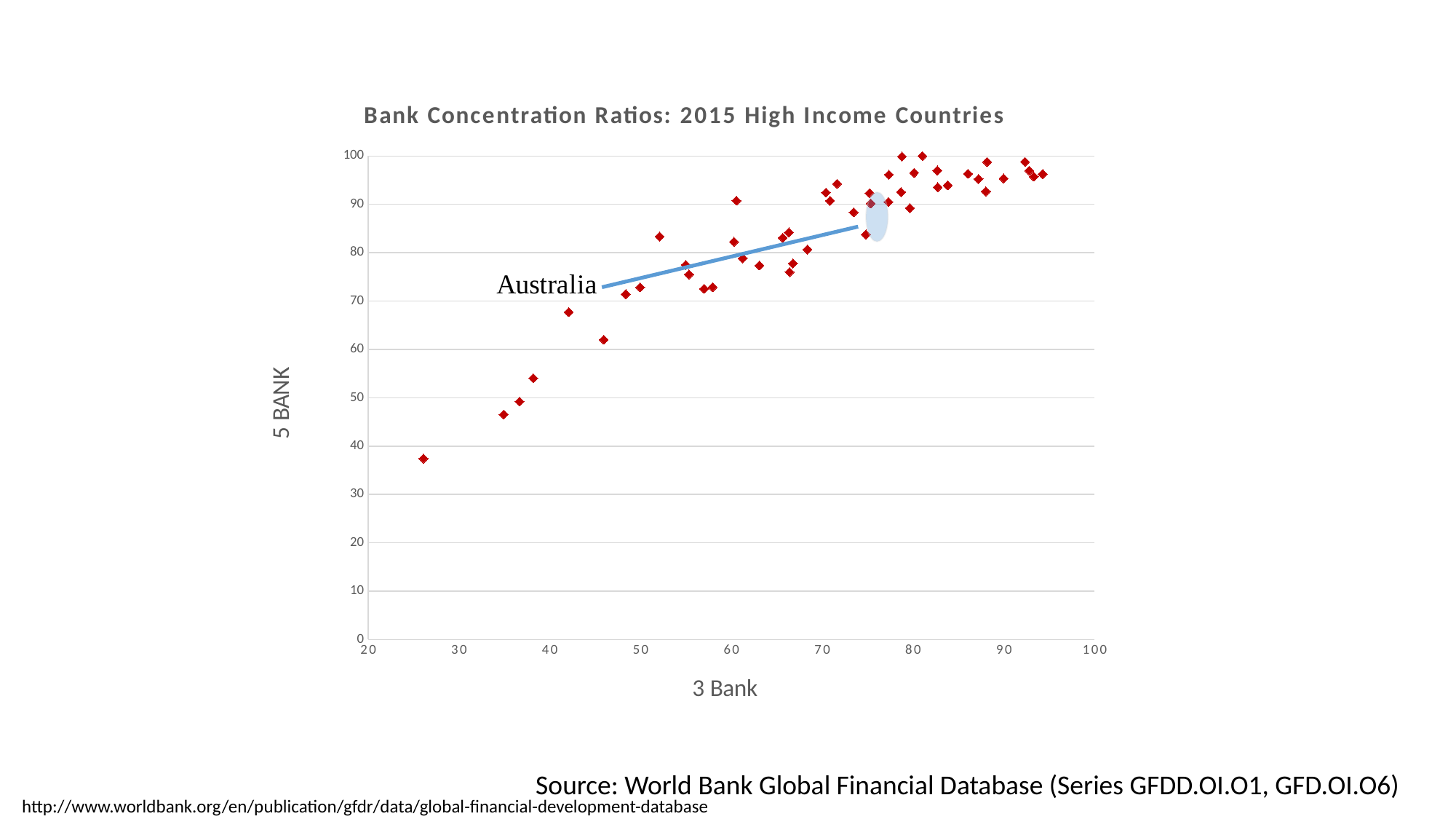
Is the 3 Bank value for the point labelled Australia greater or less than 80? less What is the title of the chart? Bank Concentration Ratios: 2015 High Income Countries Is the 3 Bank value of the leftmost point on the chart greater or less than 30? less Is the 3 Bank value for the point labelled Australia greater or less than 70? greater What is the highest tick value shown on the vertical axis? 100 As the 3 Bank value increases along the x axis, do the 5 Bank values generally rise or fall? rise What kind of chart is shown on the slide? scatter plot Which country is explicitly labelled on the chart? Australia What is the label of the horizontal axis of the chart? 3 Bank What is the lowest tick value shown on the horizontal axis? 20